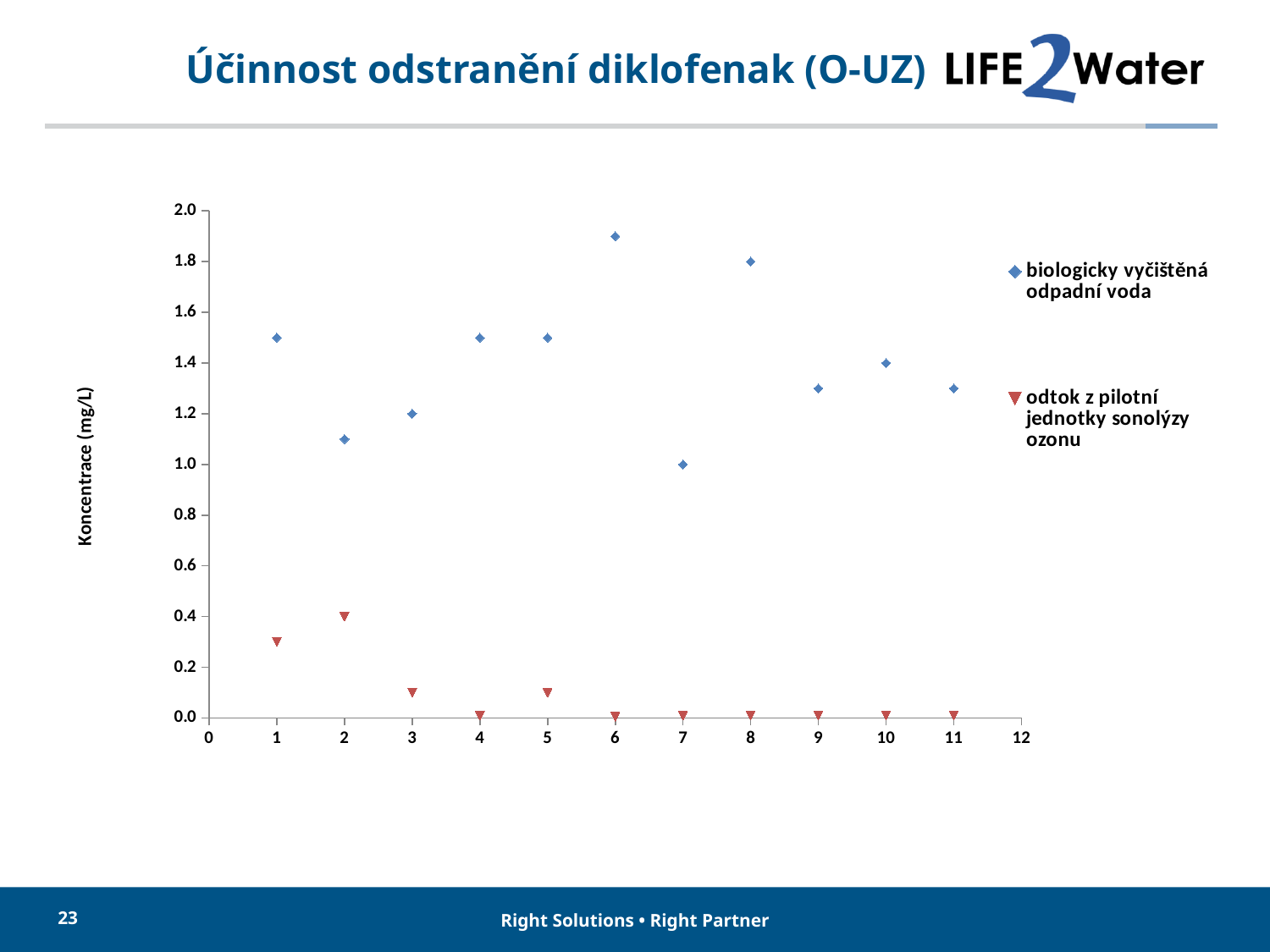
What is the label of the y axis? Koncentrace (mg/L) What kind of chart is shown on the slide? scatter chart At which x value does the series 'biologicky vyčištěná odpadní voda' have its lowest concentration? 7 What is the concentration of 'odtok z pilotní jednotky sonolýzy ozonu' at x = 2? 0.4 Which is larger: the value of 'biologicky vyčištěná odpadní voda' at x = 6 or at x = 8? x = 6 At which x value does the series 'biologicky vyčištěná odpadní voda' reach its highest concentration? 6 Is the value for 'odtok z pilotní jednotky sonolýzy ozonu' at x = 1 greater or less than 0.4? less Is the value for 'biologicky vyčištěná odpadní voda' at x = 6 greater or less than 1.8? greater What is the concentration of 'biologicky vyčištěná odpadní voda' at x = 7? 1.0 At which x value does the series 'odtok z pilotní jednotky sonolýzy ozonu' reach its highest concentration? 2 How many series does the legend list? 2 How many data points are plotted for the series 'biologicky vyčištěná odpadní voda'? 11